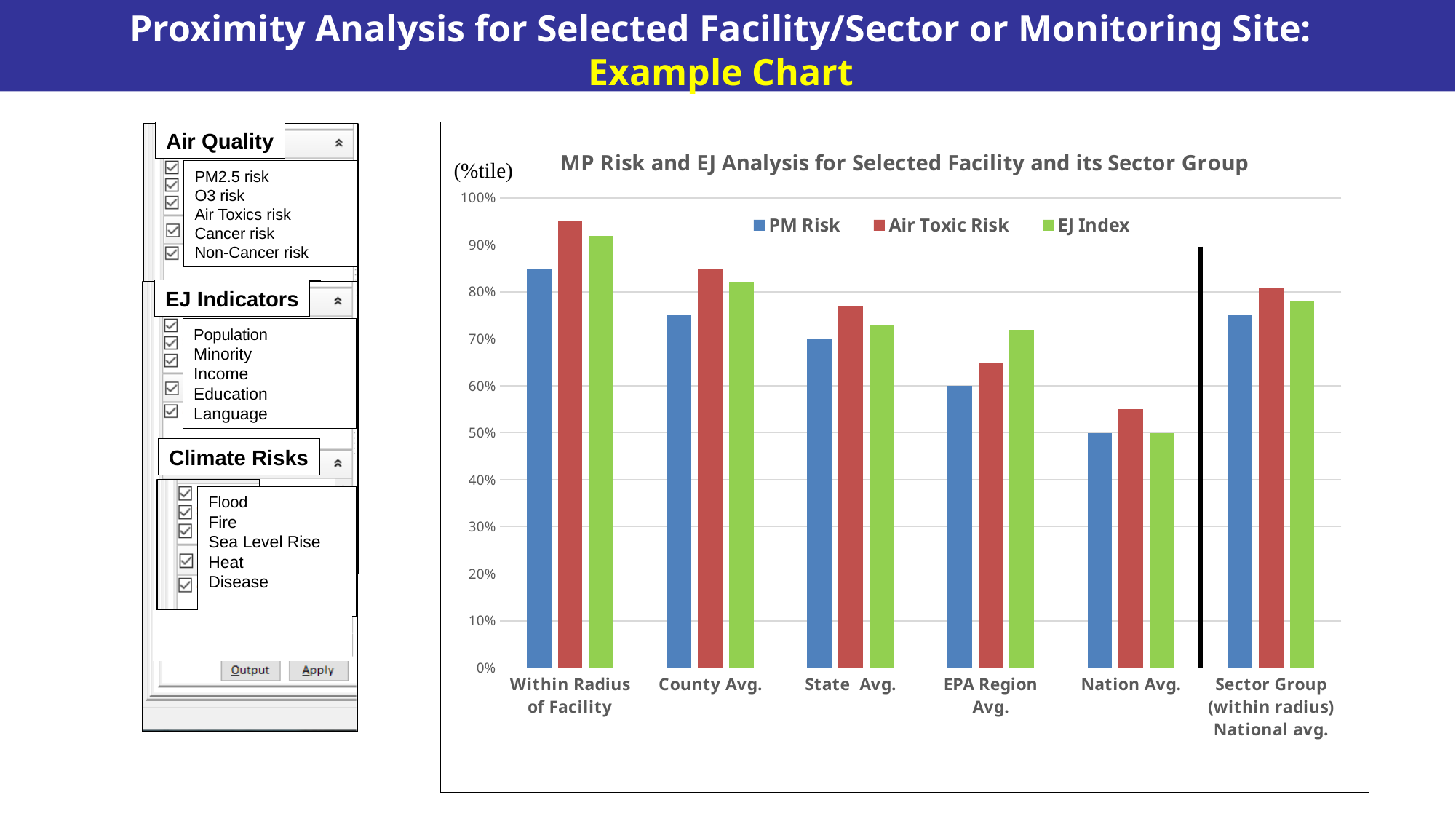
What is the title of the chart? MP Risk and EJ Analysis for Selected Facility and its Sector Group Is the EJ Index value for EPA Region Avg. greater or less than 70%? greater Which is larger for State Avg.: the PM Risk value or the Air Toxic Risk value? Air Toxic Risk How many series does the chart legend list? 3 What kind of chart is shown on the slide? bar chart How many categories are shown along the x axis of the chart? 6 Is the Air Toxic Risk value for Within Radius of Facility greater or less than 90%? greater Which category has the highest Air Toxic Risk value? Within Radius of Facility Which series is shown in green in the chart? EJ Index Which category has the lowest PM Risk value? Nation Avg. Do the PM Risk values rise or fall from Within Radius of Facility to Nation Avg.? fall Is the PM Risk value for County Avg. greater or less than 80%? less